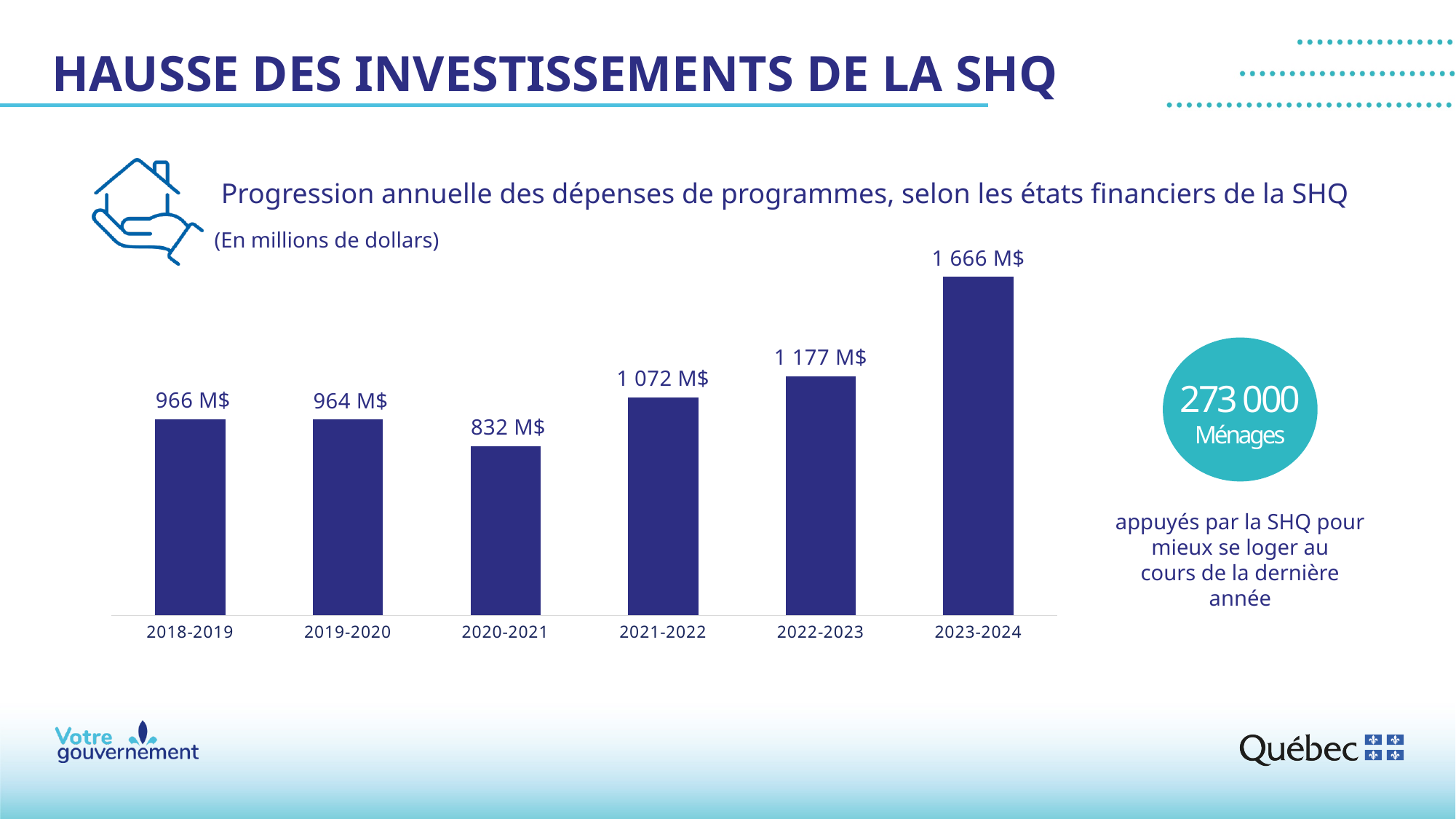
What is the difference between the values for 2018-2019 and 2020-2021? 134 M$ What kind of chart is shown? Bar chart What is the value for 2020-2021? 832 M$ Which is larger, the value for 2021-2022 or the value for 2022-2023? 2022-2023 What is the difference between the values for 2023-2024 and 2022-2023? 489 M$ What is the value for 2021-2022? 1 072 M$ Which year has the highest value? 2023-2024 What is the value for 2018-2019? 966 M$ What is the value for 2023-2024? 1 666 M$ Which year has the lowest value? 2020-2021 In what unit are the chart values expressed? En millions de dollars How many years are shown on the chart? 6